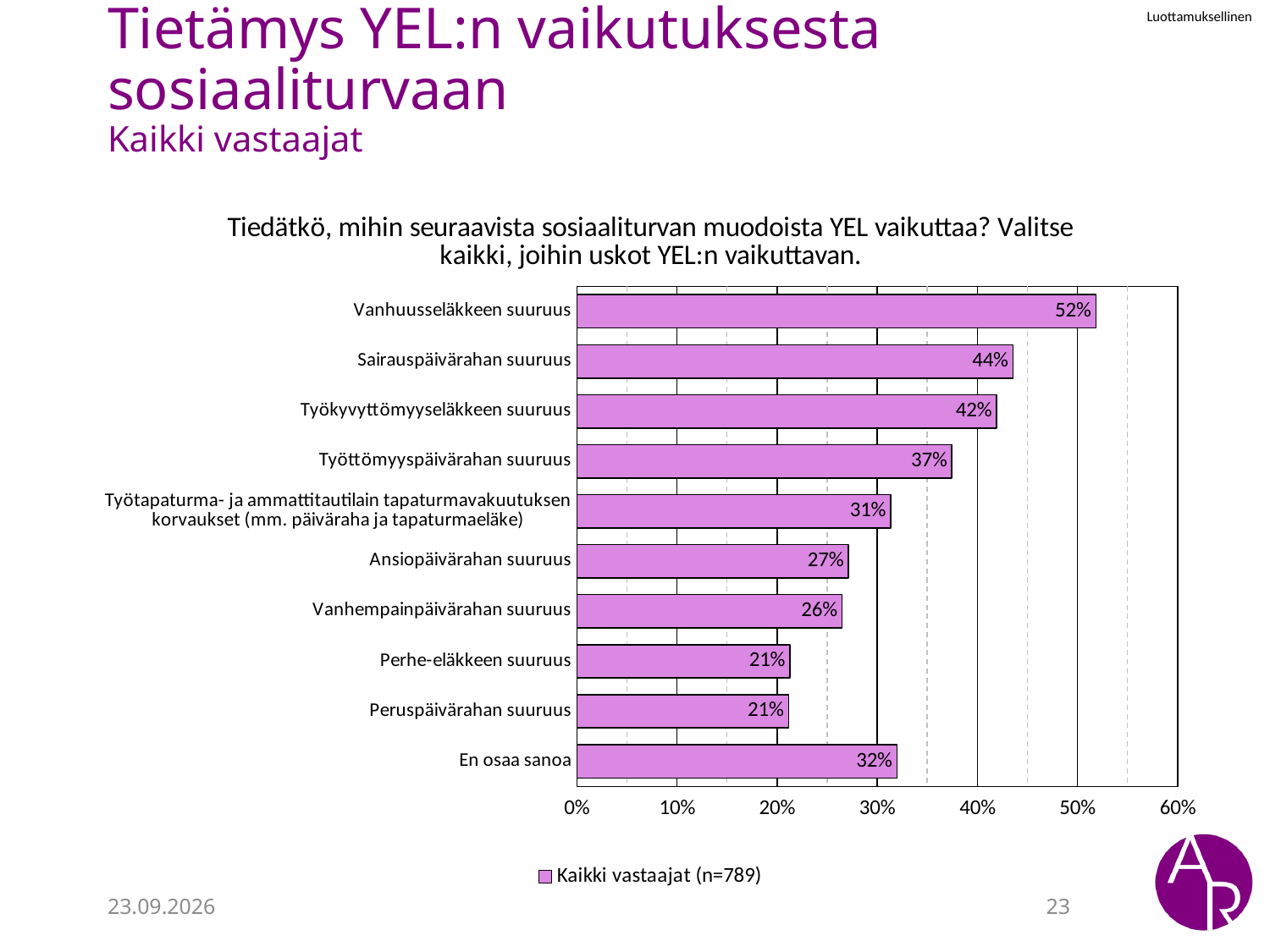
What is the difference between Vanhuusseläkkeen suuruus and Peruspäivärahan suuruus? 31% How many series does the legend list? 1 Which is larger, Ansiopäivärahan suuruus or En osaa sanoa? En osaa sanoa What is the value for Vanhuusseläkkeen suuruus? 52% What kind of chart is shown on the slide? Bar chart What is the value for En osaa sanoa? 32% What is the legend entry for the series shown? Kaikki vastaajat (n=789) What is the value for Työttömyyspäivärahan suuruus? 37% What is the difference between Sairauspäivärahan suuruus and Työkyvyttömyyseläkkeen suuruus? 2% How many categories are shown in the chart? 10 Is the value for Vanhempainpäivärahan suuruus greater or less than 30%? less Which category has the highest value? Vanhuusseläkkeen suuruus